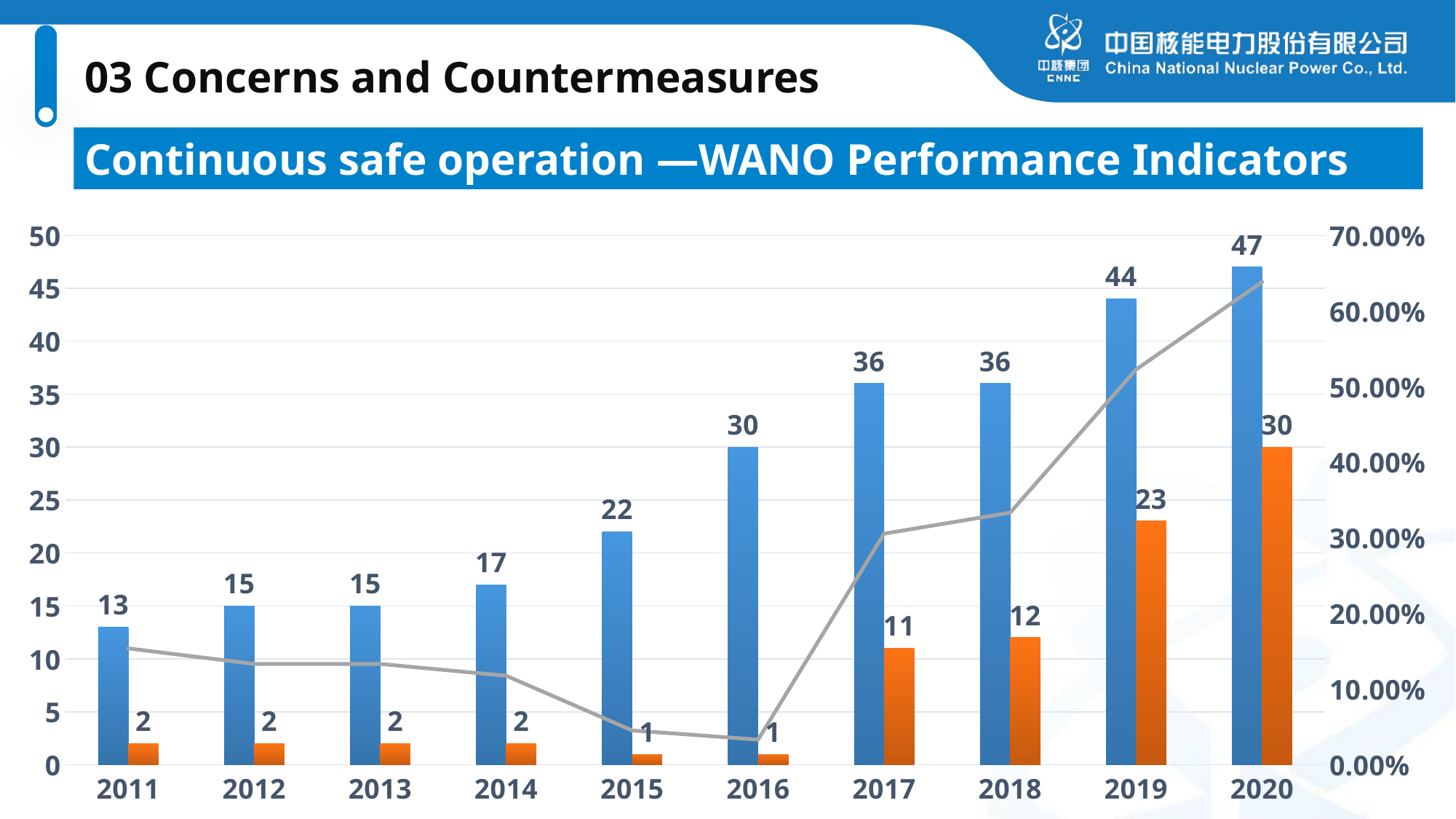
Which years have the lowest orange bar value? 2015 and 2016 Which is larger, the orange bar for 2017 or the orange bar for 2018? 2018 Which year has the highest blue bar? 2020 Do the blue bar values generally rise or fall from 2011 to 2020? rise What is the value of the blue bar for 2016? 30 What is the value of the orange bar for 2019? 23 How many years are shown on the x axis? 10 What is the difference between the blue bar and the orange bar in 2020? 17 Is the grey line value for 2020 on the right axis greater or less than 60.00%? greater What is the difference between the blue bar values for 2019 and 2018? 8 What is the value of the blue bar for 2020? 47 Is the grey line value for 2016 on the right axis greater or less than 10.00%? less